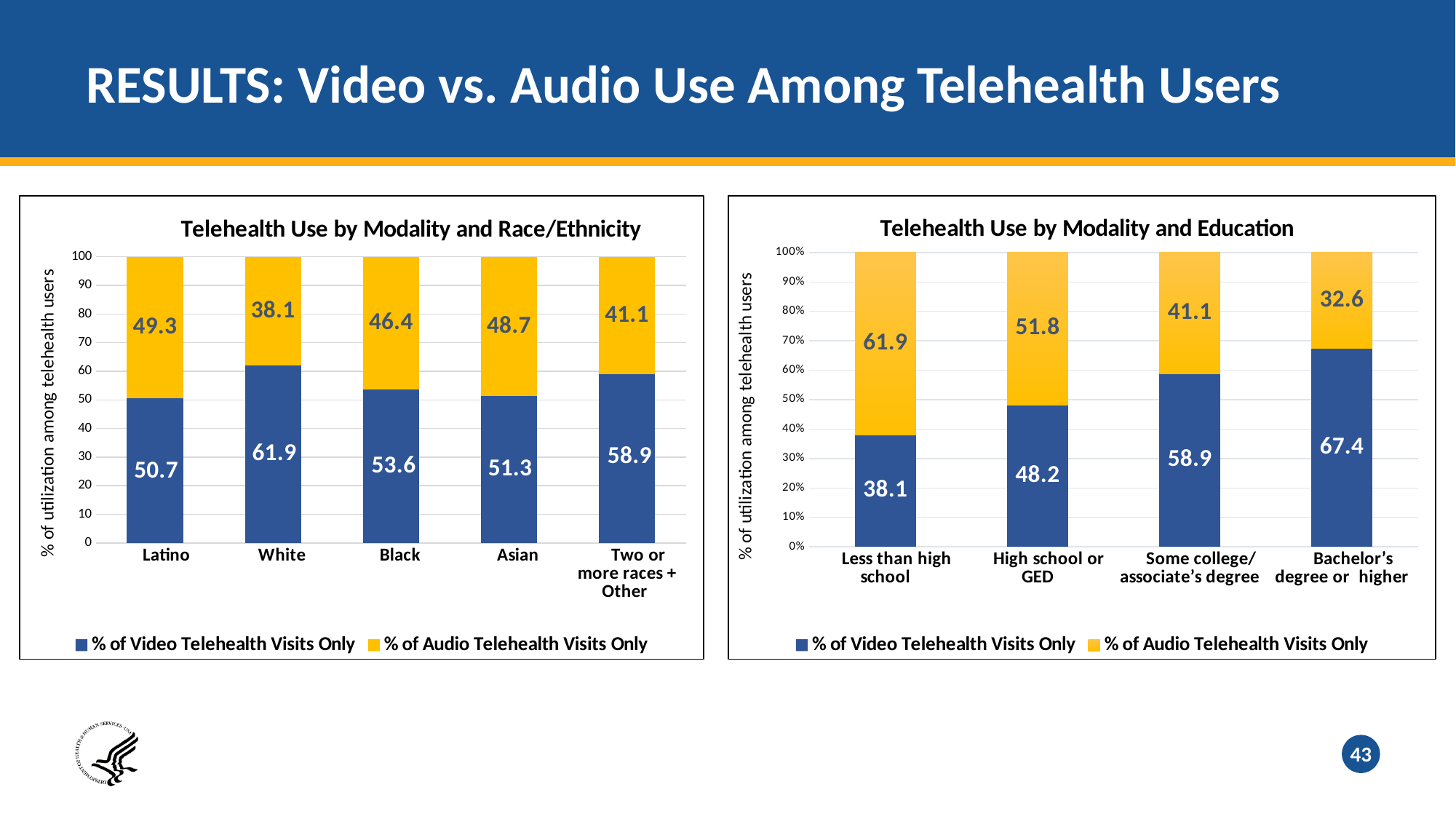
In the 'Telehealth Use by Modality and Race/Ethnicity' chart, which category has the lowest % of Audio Telehealth Visits Only? White In the 'Telehealth Use by Modality and Education' chart, does the % of Video Telehealth Visits Only rise or fall as education level increases from left to right? rise What kind of chart is 'Telehealth Use by Modality and Education'? stacked bar chart In the 'Telehealth Use by Modality and Education' chart, what is the % of Audio Telehealth Visits Only for Less than high school? 61.9 In the 'Telehealth Use by Modality and Education' chart, what is the % of Video Telehealth Visits Only for Bachelor's degree or higher? 67.4 In the 'Telehealth Use by Modality and Race/Ethnicity' chart, what is the % of Video Telehealth Visits Only for Latino? 50.7 In the 'Telehealth Use by Modality and Education' chart, how many series does the legend list? 2 In the 'Telehealth Use by Modality and Race/Ethnicity' chart, which category has the highest % of Video Telehealth Visits Only? White In the 'Telehealth Use by Modality and Race/Ethnicity' chart, what is the difference between the % of Video Telehealth Visits Only for White and for Latino? 11.2 In the 'Telehealth Use by Modality and Race/Ethnicity' chart, what is the % of Audio Telehealth Visits Only for White? 38.1 In the 'Telehealth Use by Modality and Education' chart, which category has the lowest % of Video Telehealth Visits Only? Less than high school In the 'Telehealth Use by Modality and Race/Ethnicity' chart, how many race/ethnicity categories are shown? 5